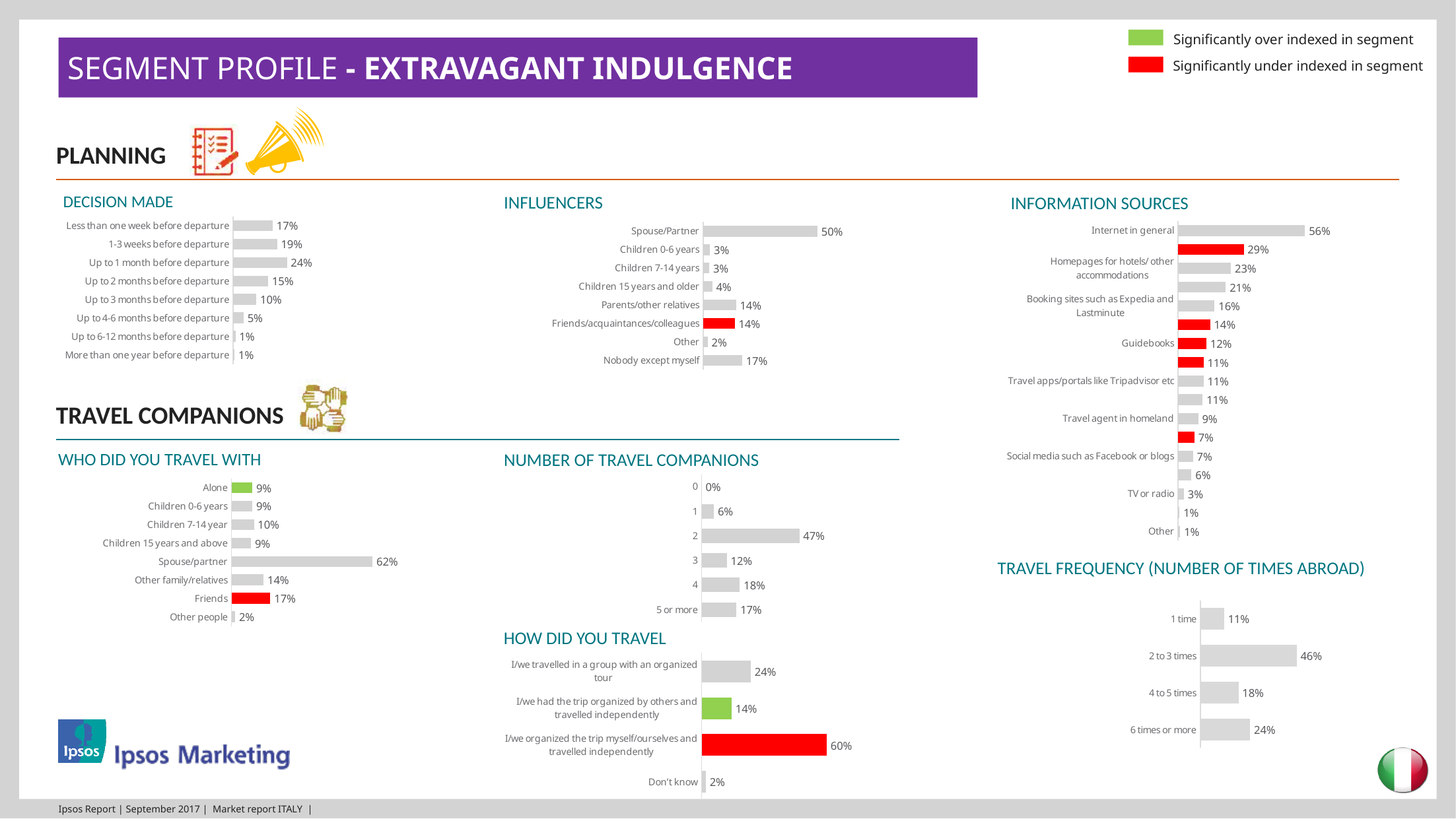
In the INFORMATION SOURCES chart, which category has the highest value? Internet in general In the NUMBER OF TRAVEL COMPANIONS chart, which category has the lowest value? 0 In the NUMBER OF TRAVEL COMPANIONS chart, what is the value for 2 companions? 47% In the DECISION MADE chart, what is the value for 'Up to 1 month before departure'? 24% In the INFLUENCERS chart, what is the value for Spouse/Partner? 50% How many categories are shown in the WHO DID YOU TRAVEL WITH chart? 8 In the DECISION MADE chart, which category has the highest value? Up to 1 month before departure In the HOW DID YOU TRAVEL chart, what is the value for 'I/we organized the trip myself/ourselves and travelled independently'? 60% In the TRAVEL FREQUENCY chart, which is larger: '2 to 3 times' or '6 times or more'? 2 to 3 times In the WHO DID YOU TRAVEL WITH chart, what is the value for Spouse/partner? 62% What type of chart is the TRAVEL FREQUENCY (NUMBER OF TIMES ABROAD) chart? Bar chart In the INFLUENCERS chart, what is the difference between Spouse/Partner and Nobody except myself? 33%